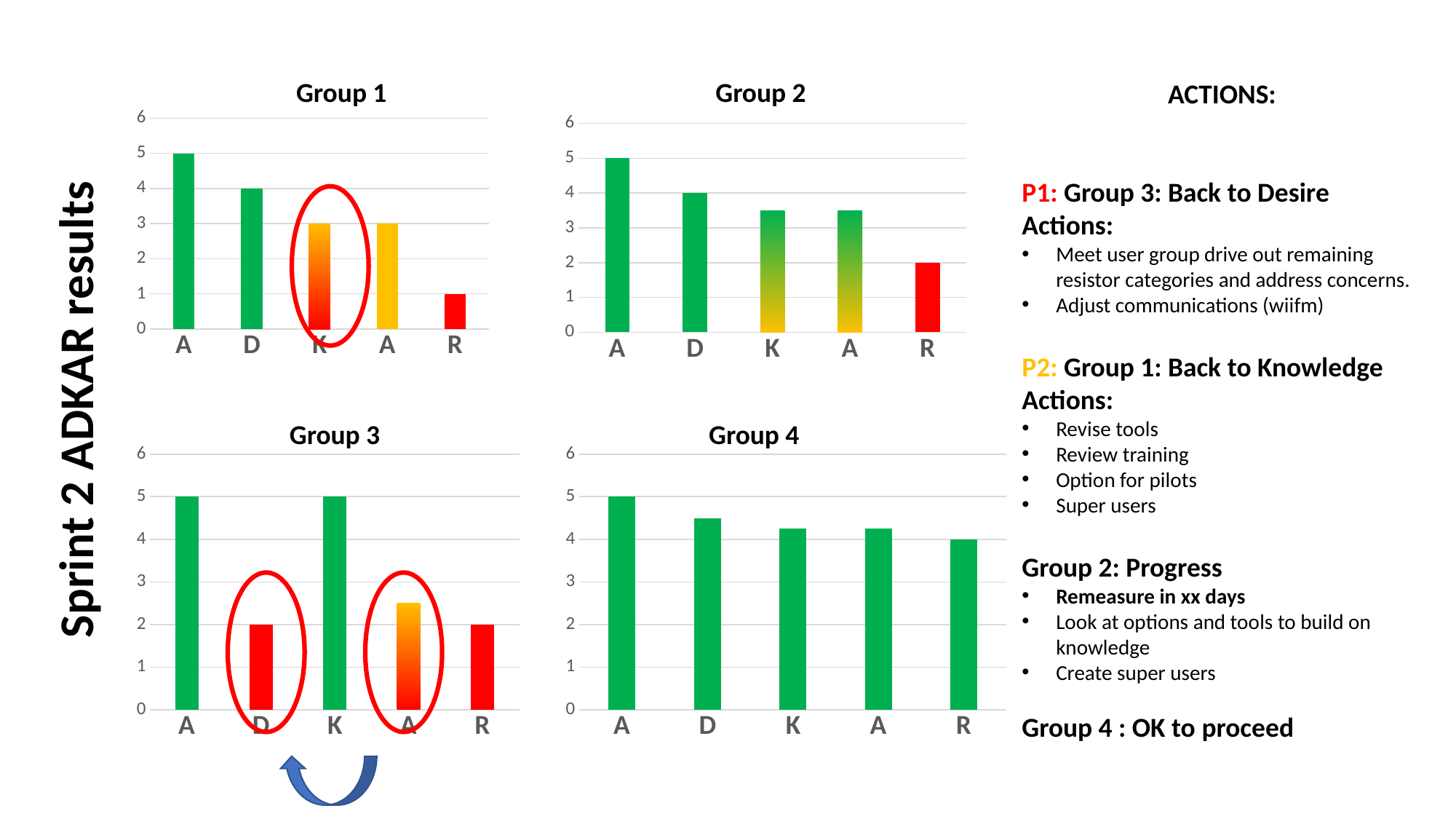
In the Group 3 chart, which is larger, the value for D or the value for K? K In the Group 2 chart, is the value for K greater or less than 3? greater In the Group 3 chart, what is the value for D? 2 In the Group 1 chart, which category has the lowest value? R In the Group 1 chart, what is the value for D? 4 In the Group 1 chart, what is the difference between the values for D and R? 3 In the Group 2 chart, do the values rise or fall from A to R along the x axis? fall In the Group 1 chart, what is the value for R? 1 In the Group 2 chart, what is the value for R? 2 What kind of chart is the Group 1 chart? bar chart How many categories are shown on the x axis of the Group 4 chart? 5 In the Group 4 chart, is the value for D greater or less than 4? greater